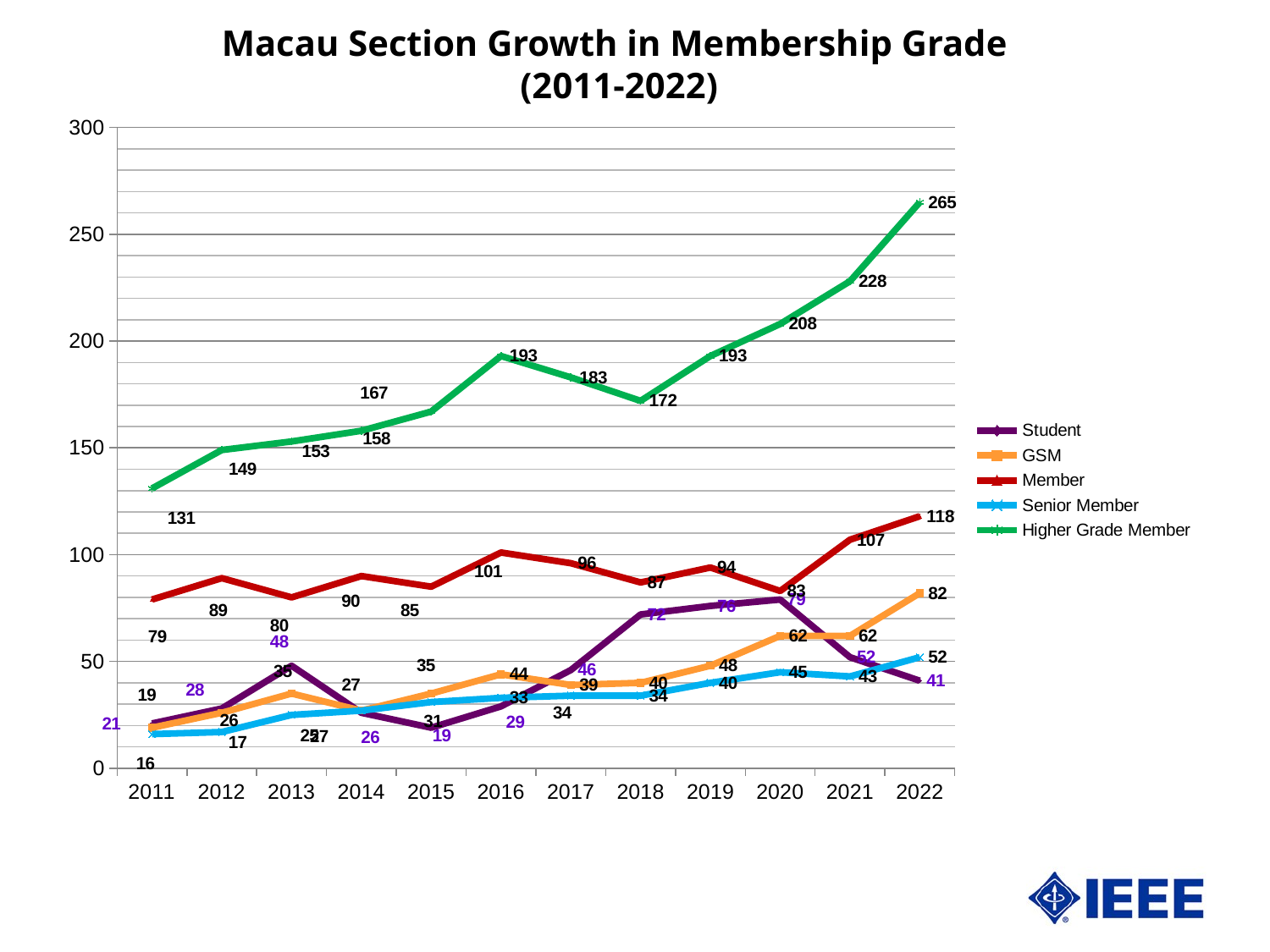
What is the Member value in 2021? 107 What is the Higher Grade Member value in 2022? 265 What is the GSM value in 2020? 62 In which year is the Higher Grade Member series at its highest? 2022 In which year is the Higher Grade Member series at its lowest? 2011 By how much did the Higher Grade Member value increase from 2021 to 2022? 37 How many years are plotted along the x axis? 12 In 2022, which is larger: GSM or Senior Member? GSM Is the Higher Grade Member value for 2018 greater or less than 150? greater Does the Higher Grade Member series rise or fall from 2019 to 2022? rise How many series does the legend list? 5 What kind of chart is shown on the slide? line chart